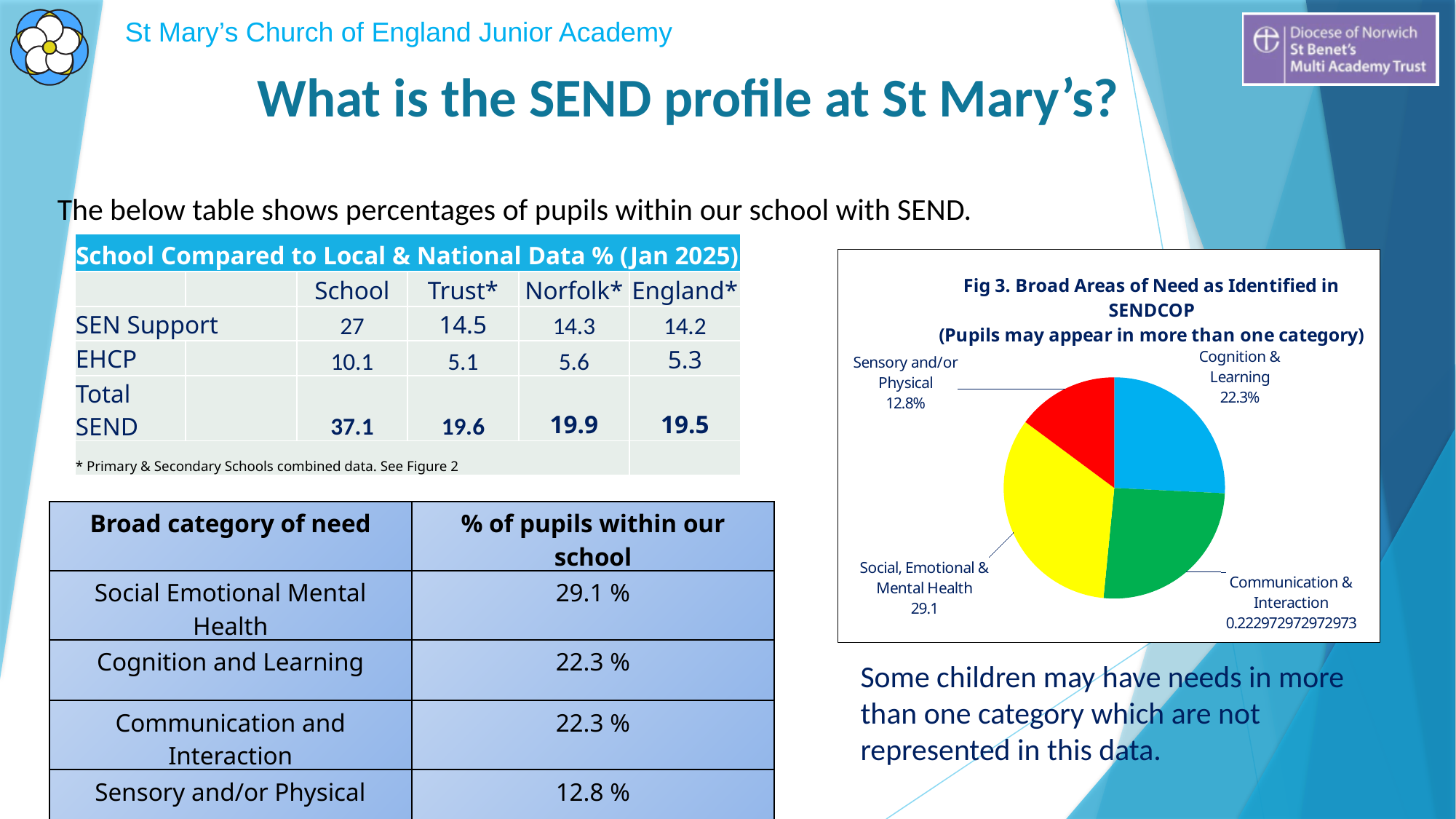
Which category has the smallest slice in the pie chart? Sensory and/or Physical In the pie chart, what value is printed for Communication & Interaction? 0.222972972972973 How many slices does the pie chart have? 4 In the pie chart, what value is shown for Social, Emotional & Mental Health? 29.1 Which category has the largest slice in the pie chart? Social, Emotional & Mental Health What kind of chart is shown in Fig 3 on the slide? pie chart What colour is the Social, Emotional & Mental Health slice in the pie chart? yellow In the pie chart, what is the difference between the Cognition & Learning value and the Sensory and/or Physical value? 9.5% In the pie chart, what value is shown for Cognition & Learning? 22.3% In the pie chart, which is larger: Cognition & Learning or Sensory and/or Physical? Cognition & Learning In the pie chart, what value is shown for Sensory and/or Physical? 12.8% What is the title of the pie chart? Fig 3. Broad Areas of Need as Identified in SENDCOP (Pupils may appear in more than one category)